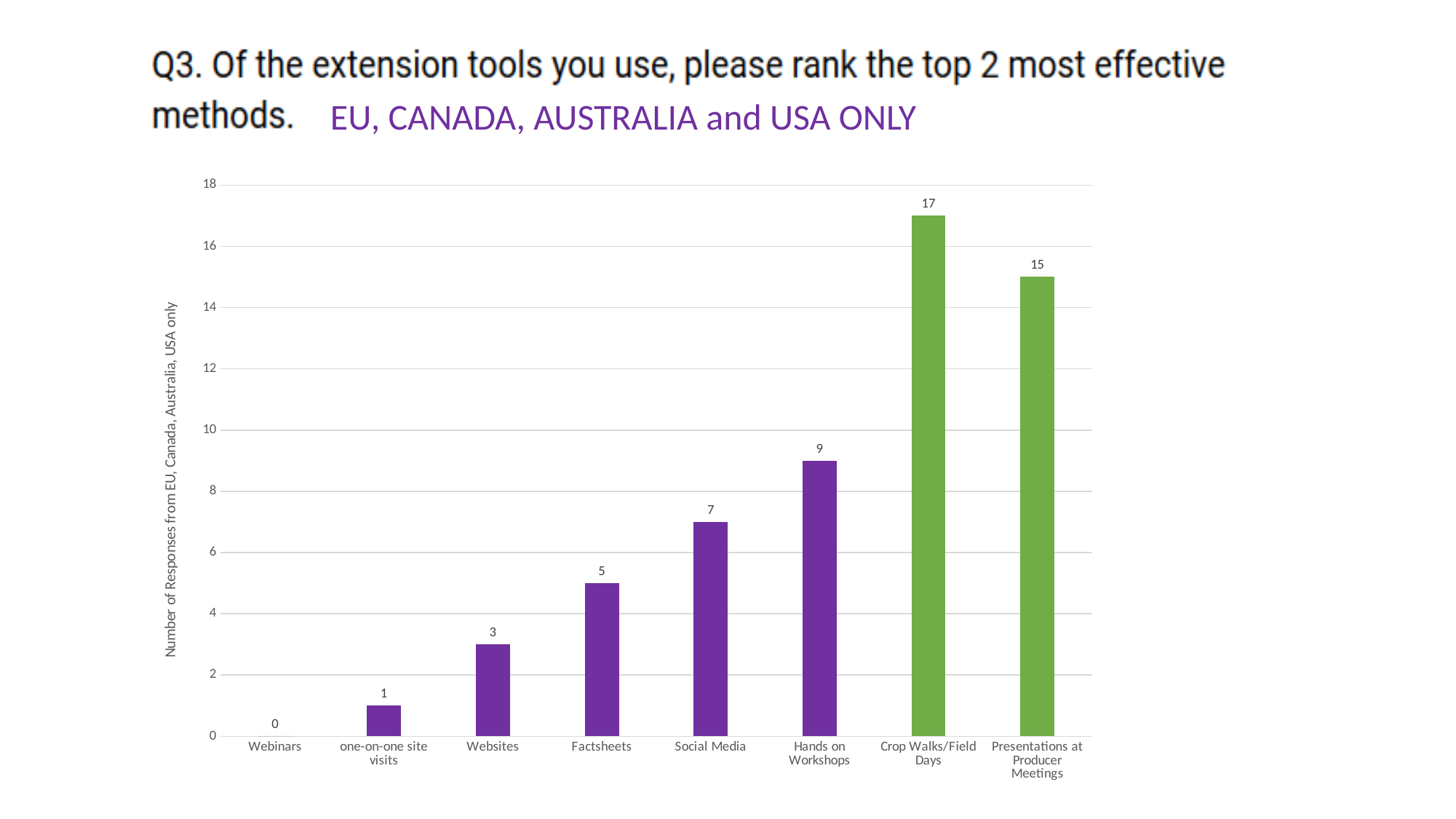
What kind of chart is shown on the slide? bar chart What is the value for Crop Walks/Field Days? 17 Which category has the highest value? Crop Walks/Field Days Is the value for Presentations at Producer Meetings greater or less than 14? greater Which category has the lowest value? Webinars How many categories are shown on the x axis? 8 What is the value for Social Media? 7 What is the label of the vertical axis? Number of Responses from EU, Canada, Australia, USA only Do the values rise or fall from left to right along the x axis? rise Which is larger, the value for Hands on Workshops or the value for Factsheets? Hands on Workshops What is the difference between the values for Crop Walks/Field Days and Presentations at Producer Meetings? 2 What is the value for Webinars? 0